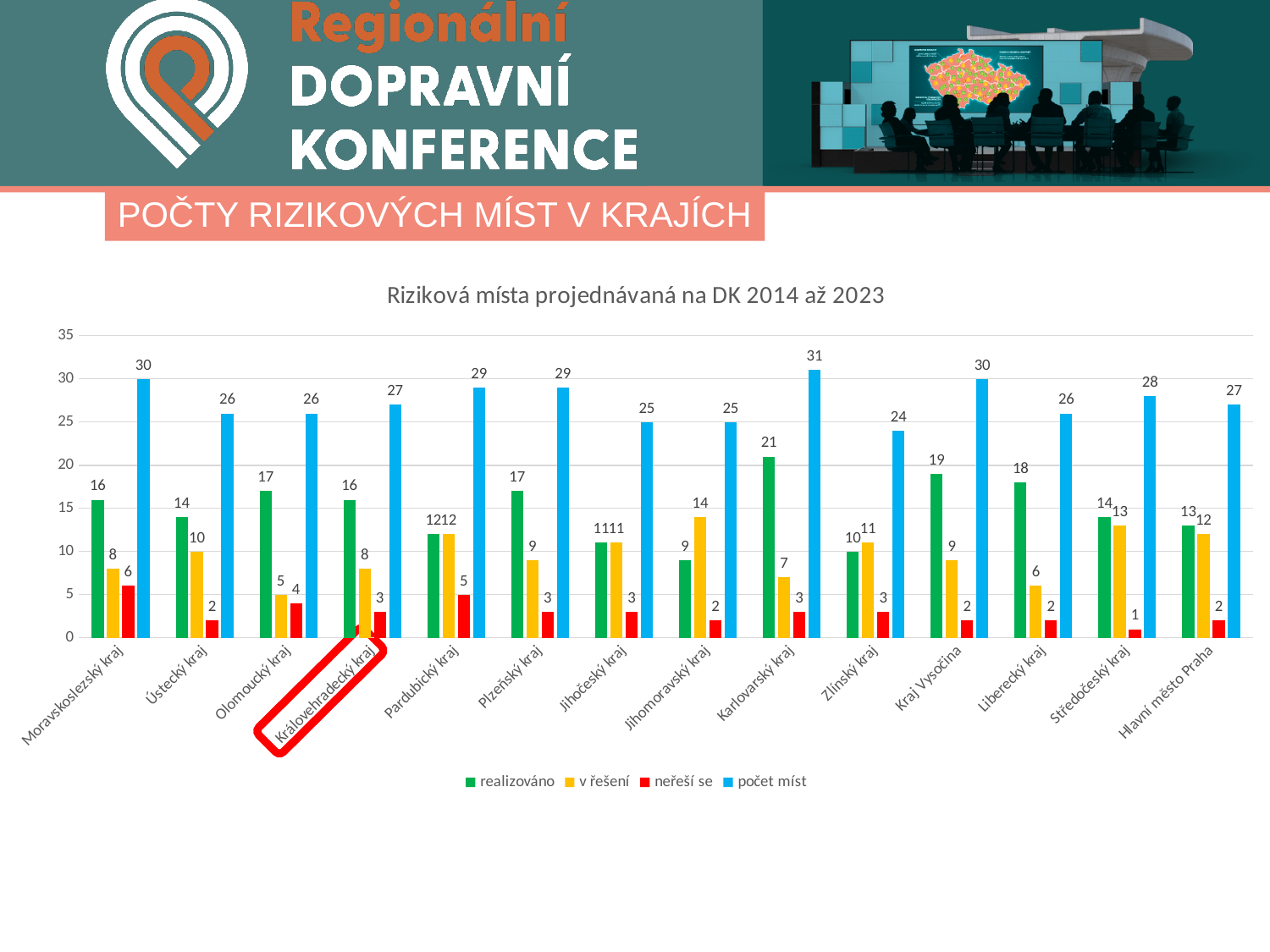
Which region has the lowest neřeší se value? Středočeský kraj Which region has the highest počet míst value? Karlovarský kraj How many regions are shown on the x axis? 14 What is the title of the chart? Riziková místa projednávaná na DK 2014 až 2023 What is the realizováno value for Kraj Vysočina? 19 Which region has the lowest počet míst value? Zlínský kraj How many series does the legend list? 4 What is the v řešení value for Jihomoravský kraj? 14 What type of chart is shown? bar chart What is the difference between počet míst and realizováno for Královehradecký kraj? 11 Which is larger for Olomoucký kraj: realizováno or v řešení? realizováno What is the value of počet míst for Karlovarský kraj? 31